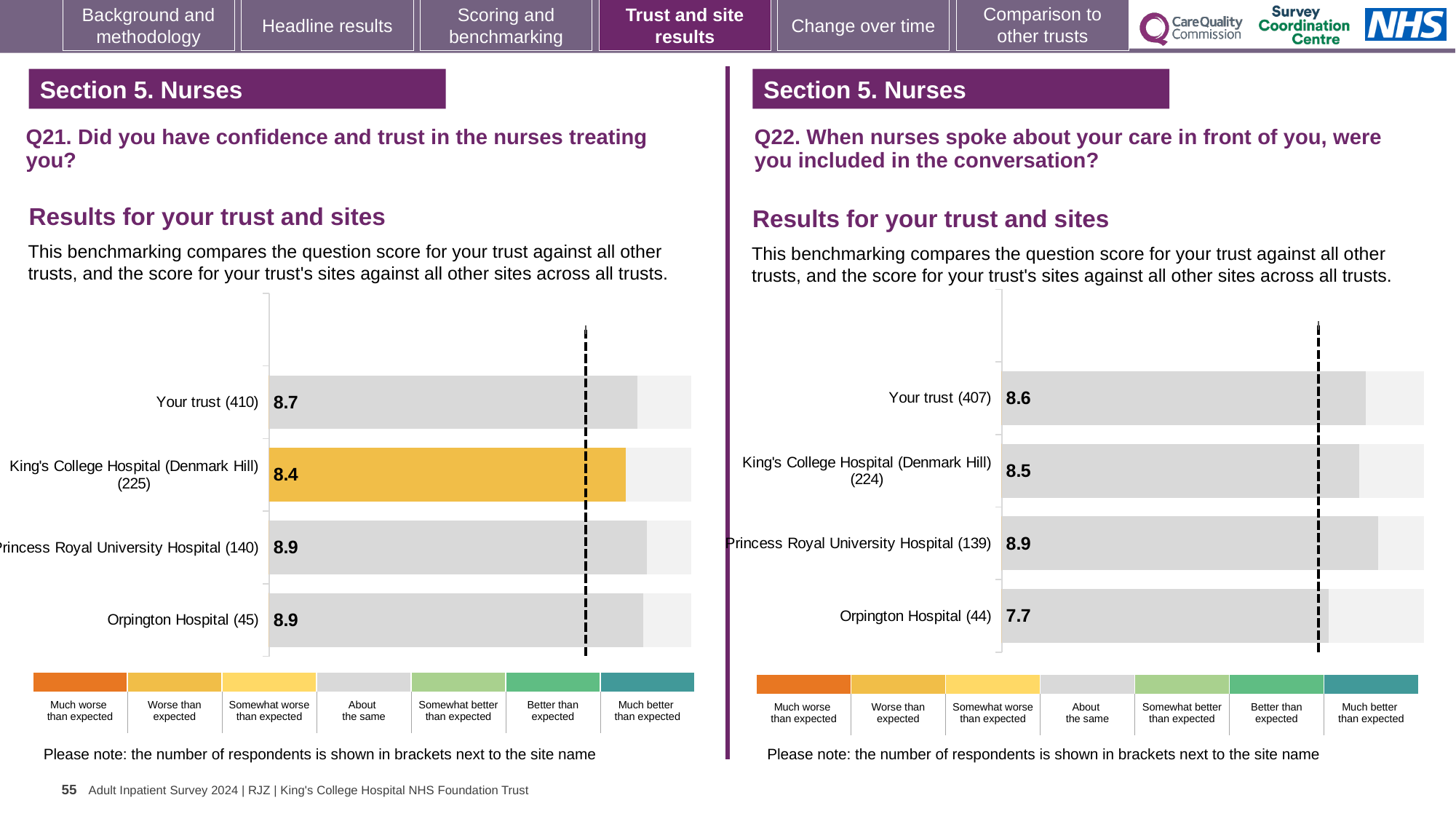
In the Q22 chart on the right, what is the difference between the scores for Your trust and Orpington Hospital? 0.9 In the Q21 chart on the left, what is the score for King's College Hospital (Denmark Hill)? 8.4 In the Q21 chart on the left, how many bars are plotted? 4 In the Q22 chart on the right, what is the score for Princess Royal University Hospital? 8.9 In the Q22 chart on the right, what is the score for Orpington Hospital? 7.7 In the Q22 chart on the right, which has the larger score: Your trust or King's College Hospital (Denmark Hill)? Your trust In the Q21 chart on the left, which site has the lowest score? King's College Hospital (Denmark Hill) In the Q22 chart on the right, which site has the highest score? Princess Royal University Hospital In the Q21 chart on the left, what is the difference between the scores for Princess Royal University Hospital and King's College Hospital (Denmark Hill)? 0.5 In the Q22 chart on the right, which site has the lowest score? Orpington Hospital In the Q21 chart on the left, what is the score for Your trust? 8.7 What kind of chart is used for the Q21 results on the left? Bar chart